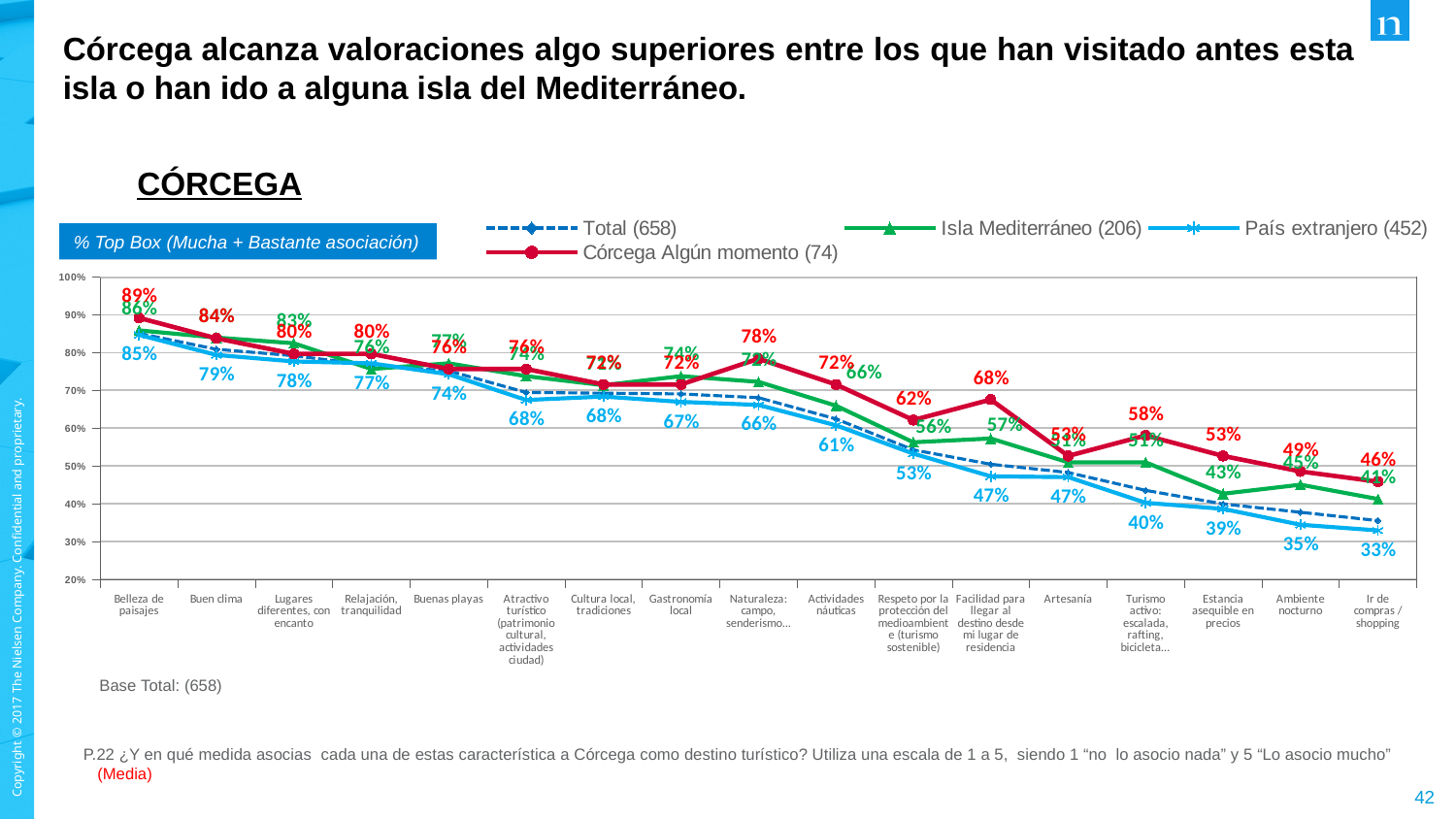
What is the value for País extranjero (452) for 'Turismo activo: escalada, rafting, bicicleta…'? 40% For 'Facilidad para llegar al destino desde mi lugar de residencia', which is larger: Córcega Algún momento (74) or País extranjero (452)? Córcega Algún momento (74) Which category has the highest value for the País extranjero (452) series? Belleza de paisajes What is the value for Córcega Algún momento (74) for 'Belleza de paisajes'? 89% What is the base total shown below the chart? 658 What is the difference between Córcega Algún momento (74) and País extranjero (452) for 'Ir de compras / shopping'? 13 percentage points What type of chart is shown on the slide? Line chart What is the value for País extranjero (452) for 'Ir de compras / shopping'? 33% Which category has the lowest value for the País extranjero (452) series? Ir de compras / shopping Do the values for País extranjero (452) generally rise or fall from left to right along the x axis? Fall How many series does the legend list? 4 How many categories are plotted along the x axis? 17